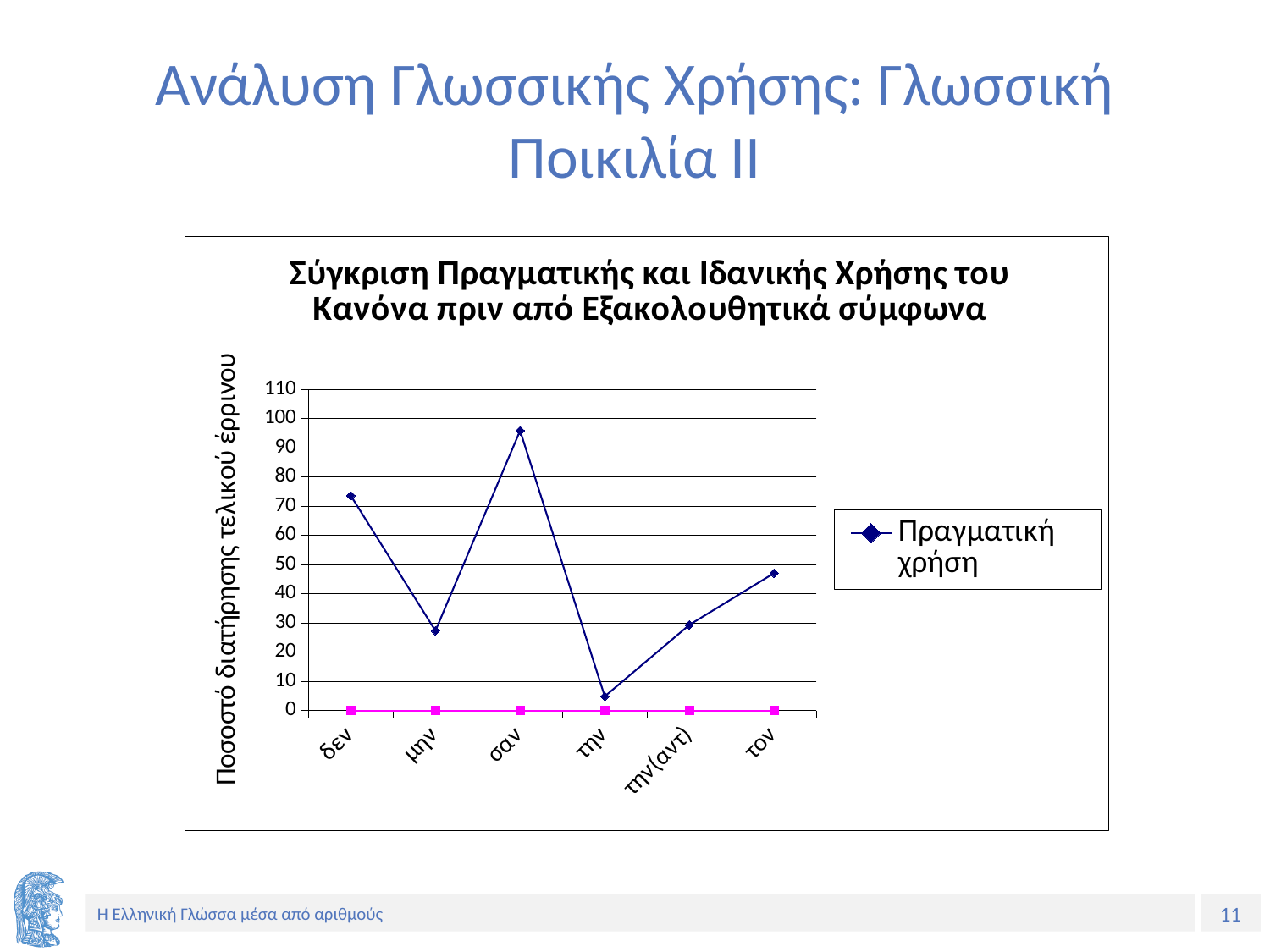
Which category has the highest value for Πραγματική χρήση? σαν What kind of chart is shown on the slide? line chart What is the label of the chart's vertical axis? Ποσοστό διατήρησης τελικού έρρινου Is the value for σαν greater or less than 90? greater Which has the larger value for Πραγματική χρήση, δεν or τον? δεν Does the Πραγματική χρήση line rise or fall from σαν to την? fall How many categories are shown on the x axis of the chart? 6 Is the value for μην greater or less than 40? less How many series does the chart's legend list? 1 Is the value for δεν greater or less than 60? greater Which category has the lowest value for Πραγματική χρήση? την